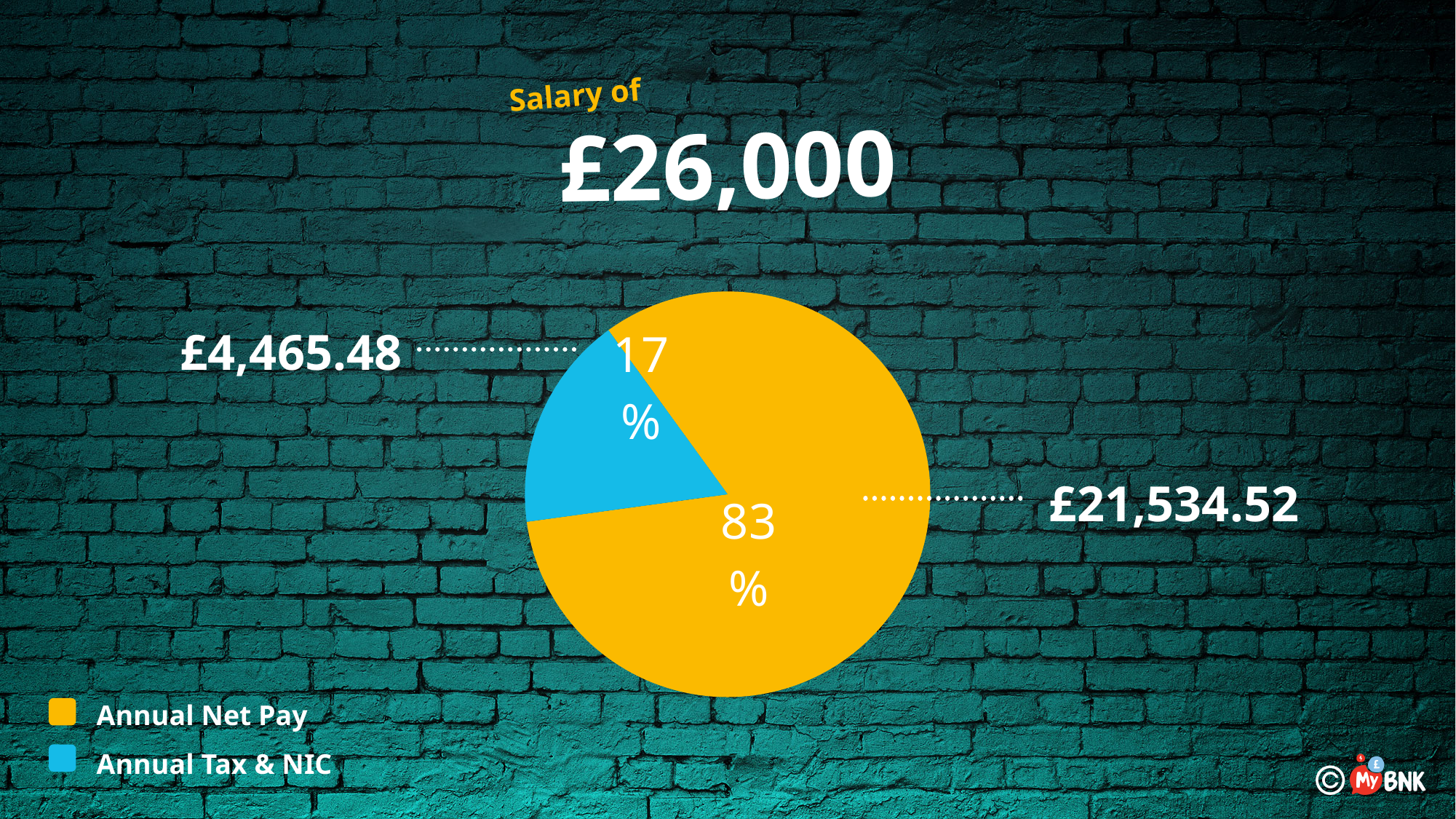
Which slice of the pie is the smallest? Annual Tax & NIC What kind of chart is shown on the slide? pie chart What is the value shown for Annual Net Pay? £21,534.52 How many entries does the legend list? 2 What percentage of the pie does Annual Net Pay represent? 83% Which is larger, Annual Net Pay or Annual Tax & NIC? Annual Net Pay What is the value shown for Annual Tax & NIC? £4,465.48 Which slice of the pie is the largest? Annual Net Pay What colour is the Annual Tax & NIC slice? blue What is the difference in percentage points between the Annual Net Pay and Annual Tax & NIC slices? 66 What percentage of the pie does Annual Tax & NIC represent? 17% How many slices does the pie chart have? 2